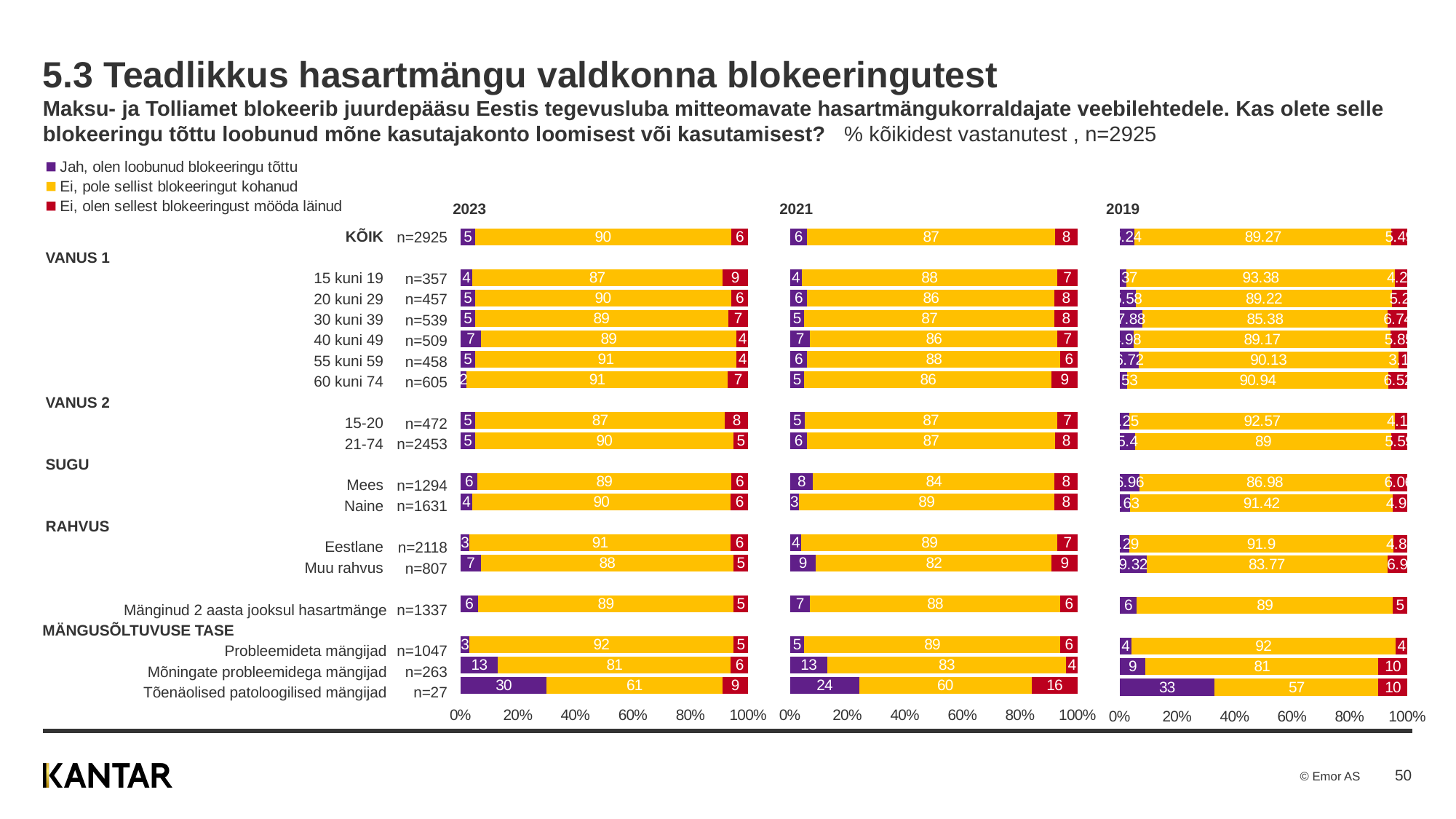
In the 2023 chart, what is the value for 'Jah, olen loobunud blokeeringu tõttu' among Tõenäolised patoloogilised mängijad? 30 In the 2023 chart, what percentage of all respondents (KÕIK) answered 'Ei, pole sellist blokeeringut kohanud'? 90 In the 2023 chart, which category has the highest share of 'Jah, olen loobunud blokeeringu tõttu'? Tõenäolised patoloogilised mängijad What kind of chart is used on this slide? Stacked bar chart How many series does the legend list? 3 In the 2019 chart, what is the value for 'Ei, pole sellist blokeeringut kohanud' among Probleemideta mängijad? 92 In the 2021 chart, what is the total of the stacked bar for Tõenäolised patoloogilised mängijad? 100 In the 2021 chart, what is the value for 'Ei, olen sellest blokeeringust mööda läinud' among Tõenäolised patoloogilised mängijad? 16 Which colour represents 'Ei, pole sellist blokeeringut kohanud' in the legend? Yellow In the 2023 chart, which category has the lowest share of 'Ei, pole sellist blokeeringut kohanud'? Tõenäolised patoloogilised mängijad For Tõenäolised patoloogilised mängijad, is the 'Ei, olen sellest blokeeringust mööda läinud' share larger in the 2021 chart or the 2023 chart? 2021 In the 2023 chart, what is the difference in the 'Jah, olen loobunud blokeeringu tõttu' share between Tõenäolised patoloogilised mängijad and Mõningate probleemidega mängijad? 17